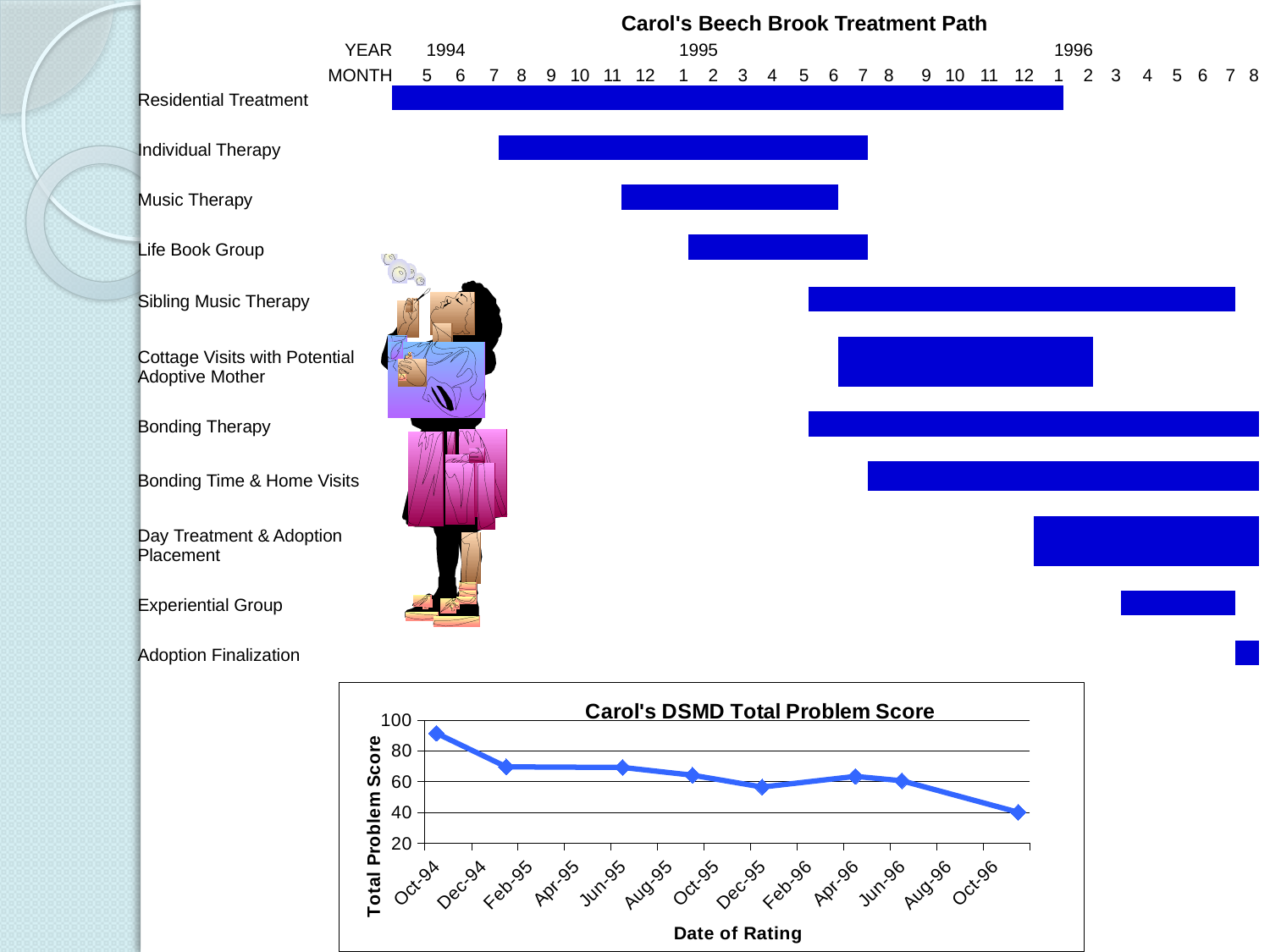
In "Carol's Beech Brook Treatment Path", which treatment activity begins earliest? Residential Treatment In "Carol's DSMD Total Problem Score", how many rating points are plotted? 8 In "Carol's DSMD Total Problem Score", which rating date has the highest Total Problem Score? Oct-94 In "Carol's DSMD Total Problem Score", is the value for Oct-94 greater or less than 80? greater In "Carol's Beech Brook Treatment Path", how many treatment activities are listed? 11 What kind of chart is "Carol's DSMD Total Problem Score"? line chart In "Carol's DSMD Total Problem Score", is the value for Dec-95 greater or less than 60? less In "Carol's DSMD Total Problem Score", does the Total Problem Score generally rise or fall from Oct-94 to Oct-96? fall What is the x-axis title of "Carol's DSMD Total Problem Score"? Date of Rating